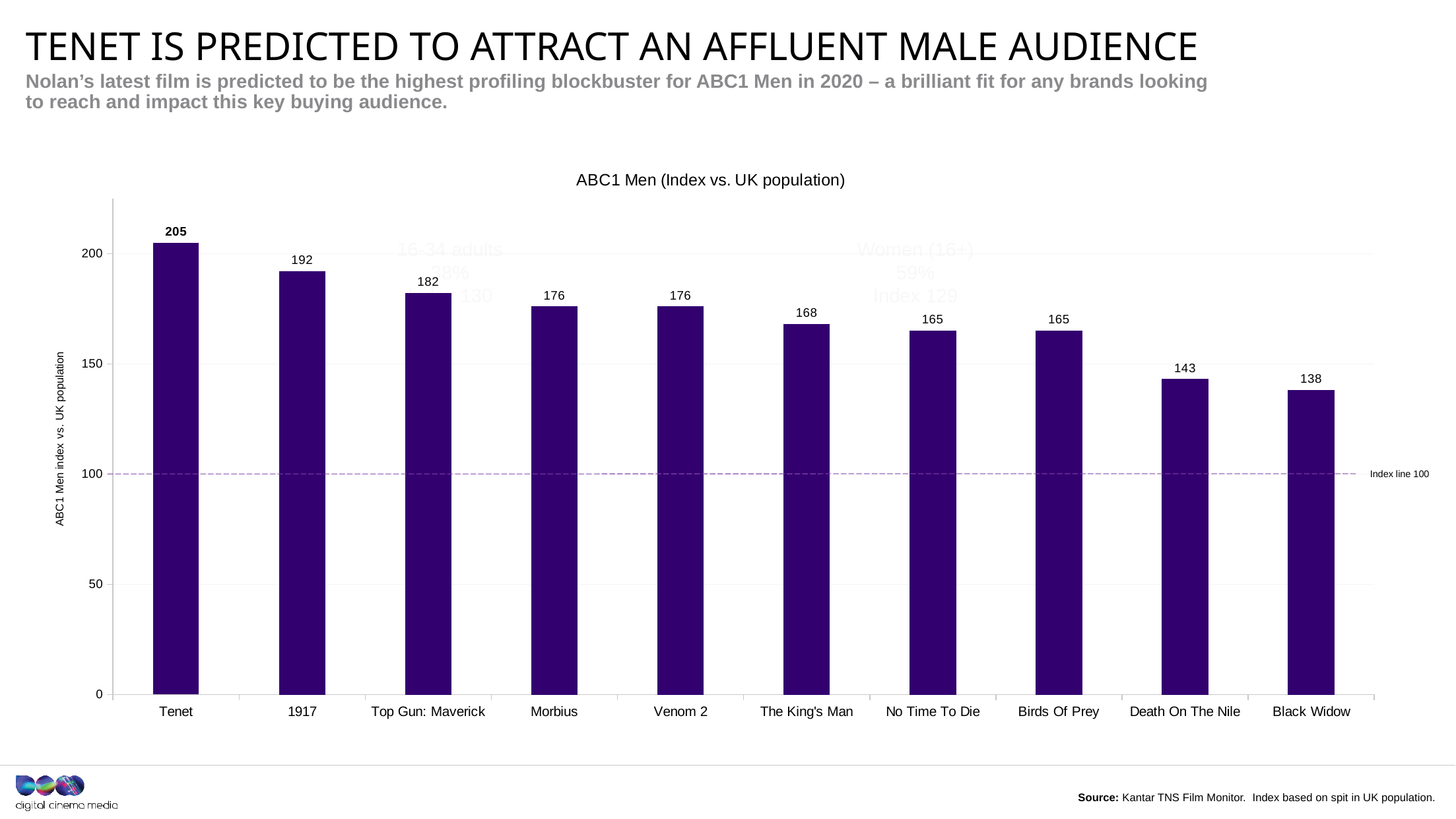
What is the ABC1 Men index value for Top Gun: Maverick? 182 Which has a higher ABC1 Men index, Morbius or Birds Of Prey? Morbius What is the difference between the ABC1 Men index for Tenet and for 1917? 13 What kind of chart is shown on the slide? Bar chart Is the ABC1 Men index for Black Widow greater or less than 150? less How many films are shown on the chart? 10 What is the ABC1 Men index value for Tenet? 205 What is the title of the chart? ABC1 Men (Index vs. UK population) Which film has the highest ABC1 Men index? Tenet What is the ABC1 Men index value for Death On The Nile? 143 Which film has the lowest ABC1 Men index? Black Widow What is the difference between the ABC1 Men index for The King's Man and for Black Widow? 30